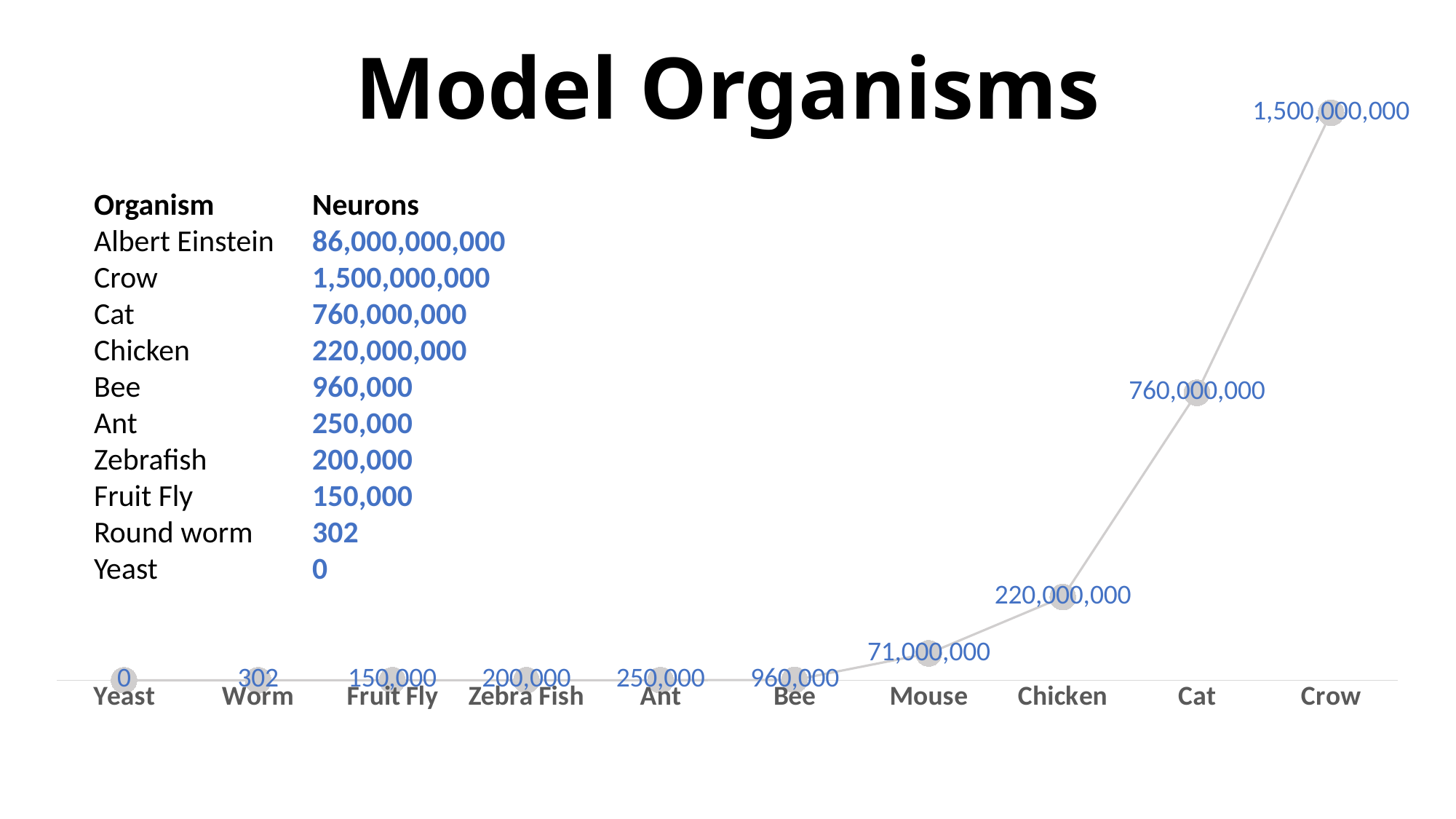
What is the value plotted for Cat in the chart? 760,000,000 What is the difference between the values for Ant and Zebra Fish in the chart? 50,000 Which category has the highest value in the chart? Crow What is the difference between the values for Crow and Cat in the chart? 740,000,000 What is the value plotted for Bee in the chart? 960,000 How many categories are plotted along the x axis of the chart? 10 Do the plotted values rise or fall from Yeast to Crow along the x axis? Rise What is the value plotted for Mouse in the chart? 71,000,000 Which category has the lowest value in the chart? Yeast What is the value plotted for Worm in the chart? 302 What kind of chart is shown on the slide? Line chart Which has a larger value in the chart, Chicken or Mouse? Chicken